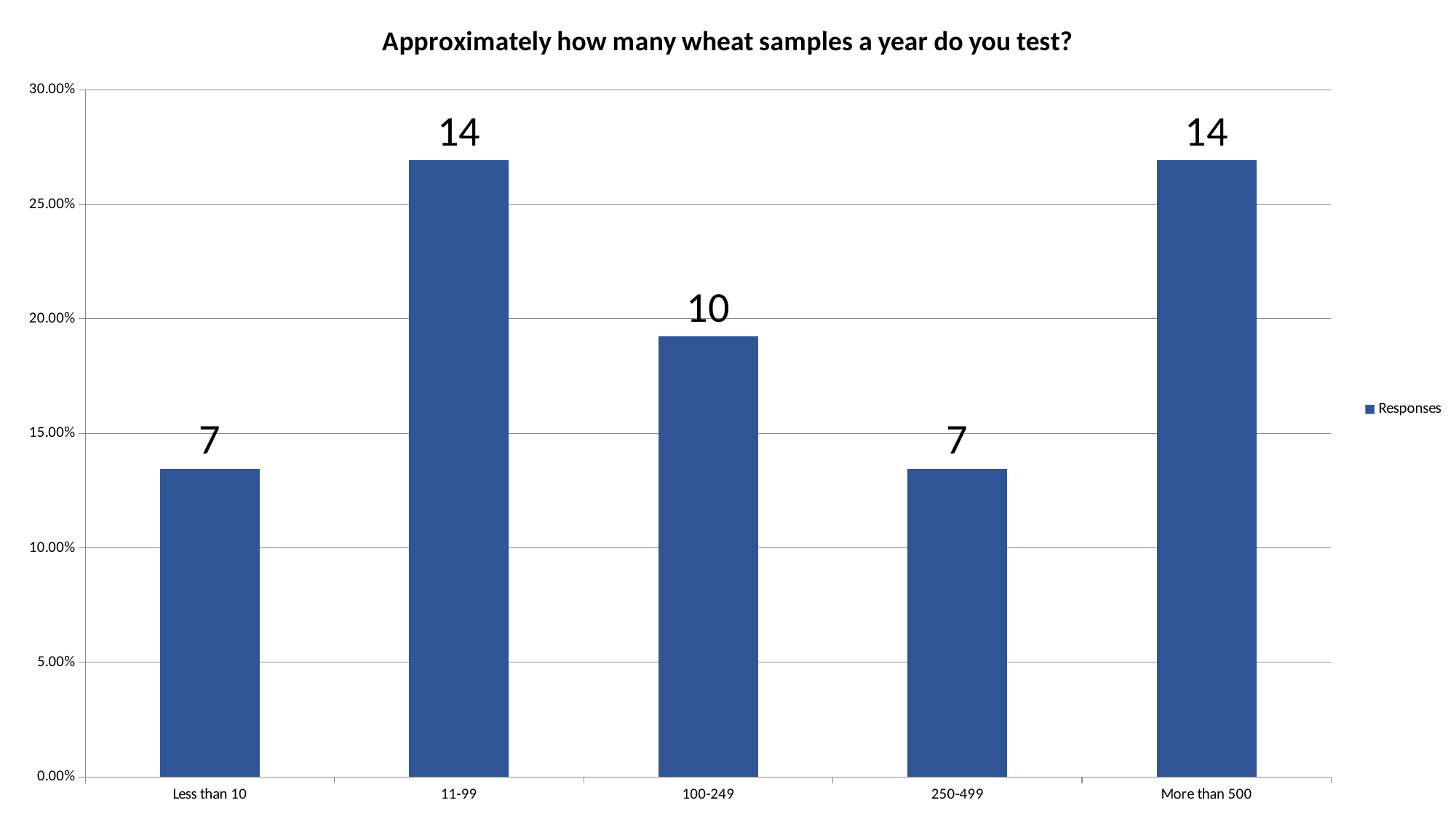
Is the bar for '100-249' greater or less than 15.00% on the axis? greater What data label is shown on the bar for the '250-499' category? 7 What is the lowest data label value shown on any bar in the chart? 7 What kind of chart is shown on the slide? Bar chart Is the bar for 'Less than 10' greater or less than 15.00% on the axis? less What is the difference between the data labels for '11-99' and '100-249'? 4 What is the highest data label value shown on any bar in the chart? 14 What data label is shown on the bar for the 'Less than 10' category? 7 What data label is shown on the bar for the 'More than 500' category? 14 What data label is shown on the bar for the '100-249' category? 10 How many categories are shown on the x axis of the chart? 5 Which bar is taller: '11-99' or '100-249'? 11-99